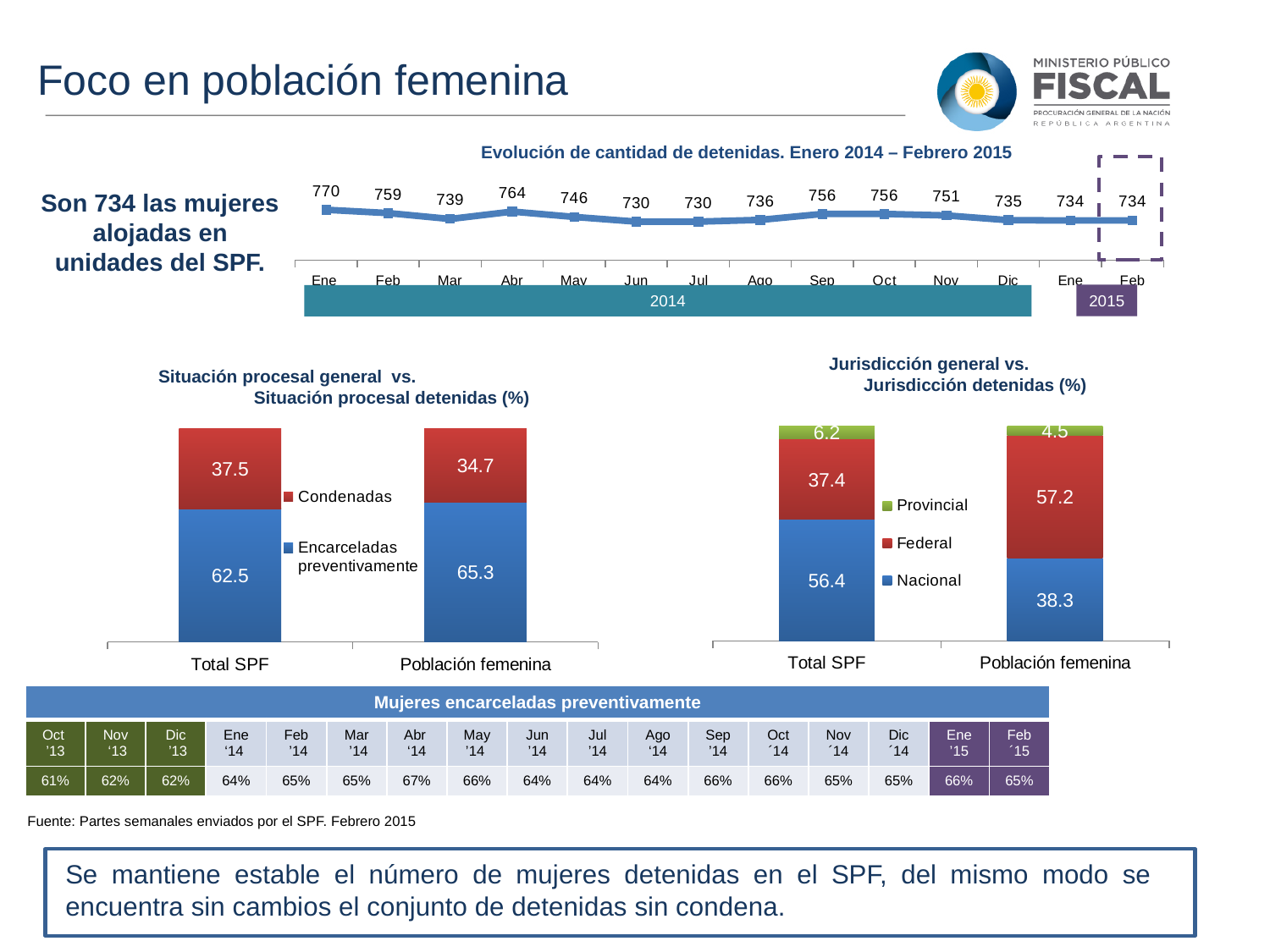
In the chart 'Situación procesal general vs. Situación procesal detenidas (%)', which is larger: Condenadas for Total SPF or Condenadas for Población femenina? Total SPF In the line chart 'Evolución de cantidad de detenidas', which month has the lowest value? Jun and Jul 2014 (730) In the chart 'Situación procesal general vs. Situación procesal detenidas (%)', what is the value of Encarceladas preventivamente for Población femenina? 65.3 What type of chart is 'Evolución de cantidad de detenidas. Enero 2014 – Febrero 2015'? Line chart How many series does the legend list in the chart 'Jurisdicción general vs. Jurisdicción detenidas (%)'? 3 In the line chart 'Evolución de cantidad de detenidas', which month has the highest value? Ene 2014 In the chart 'Jurisdicción general vs. Jurisdicción detenidas (%)', what is the Federal value for Población femenina? 57.2 In the chart 'Jurisdicción general vs. Jurisdicción detenidas (%)', what is the difference between the Nacional value for Total SPF and the Nacional value for Población femenina? 18.1 In the line chart 'Evolución de cantidad de detenidas', what is the value for Ene 2014? 770 How many data points are plotted in the line chart 'Evolución de cantidad de detenidas'? 14 In the chart 'Jurisdicción general vs. Jurisdicción detenidas (%)', what is the total of the stacked bar for Total SPF? 100.0 In the line chart 'Evolución de cantidad de detenidas', what is the difference between the Ene 2014 value and the Feb 2015 value? 36